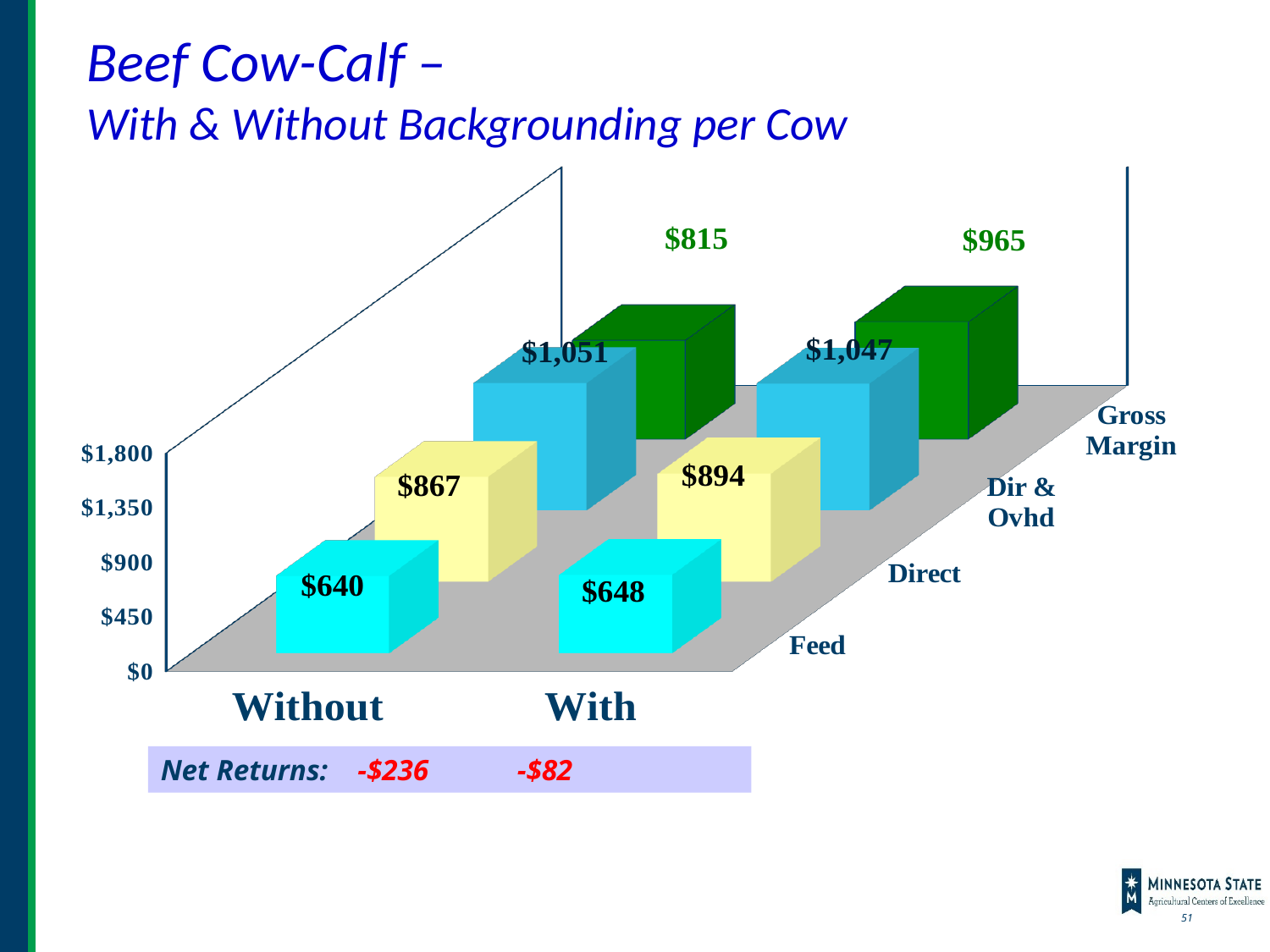
Which is larger, the Dir & Ovhd value for Without or for With backgrounding? Without What kind of chart is shown on the slide? Bar chart What is the difference between the Gross Margin values for With and Without backgrounding? $150 Which series has the lowest value for With backgrounding? Feed What is the difference between the Direct values for With and Without backgrounding? $27 What is the Gross Margin value for With backgrounding? $965 What is the Direct value for With backgrounding? $894 How many series are plotted in the chart? 4 Which series has the highest value for Without backgrounding? Dir & Ovhd What is the Net Returns value shown for With backgrounding? -$82 What is the Feed value for Without backgrounding? $640 What is the Dir & Ovhd value for Without backgrounding? $1,051